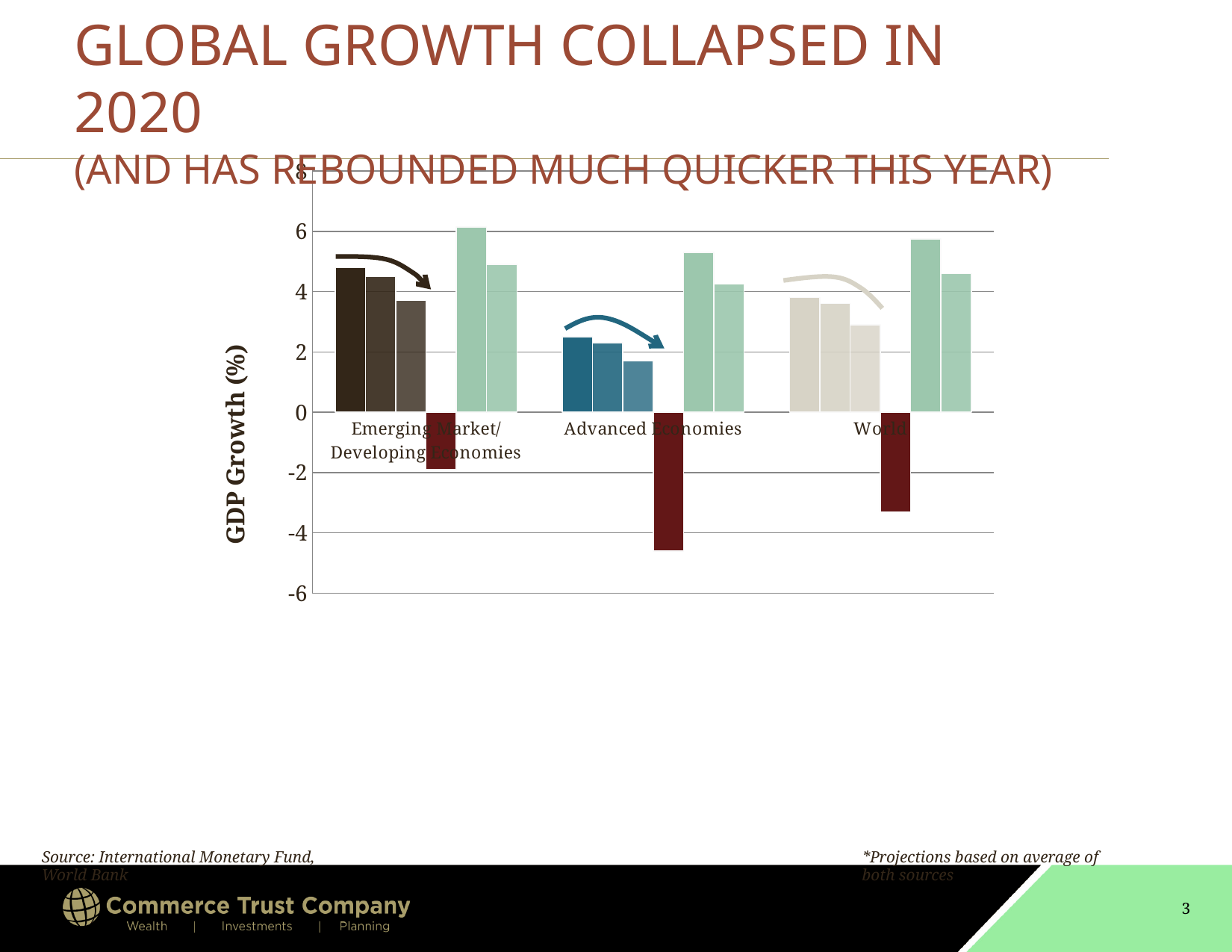
Which is taller: the first green bar for Emerging Market/Developing Economies or the first green bar for Advanced Economies? Emerging Market/Developing Economies Is the value of the first green bar for Advanced Economies greater or less than 4? greater Which negative bar is lower: the one for Advanced Economies or the one for World? Advanced Economies What kind of chart is shown on the slide? bar chart What is the label on the vertical axis of the chart? GDP Growth (%) Which category has the lowest (most negative) bar in the chart? Advanced Economies Is the value of the first (leftmost) dark bar for Advanced Economies greater or less than 2? greater Is the value of the dark red negative bar for Advanced Economies greater or less than -4? less How many categories are shown on the x axis of the chart? 3